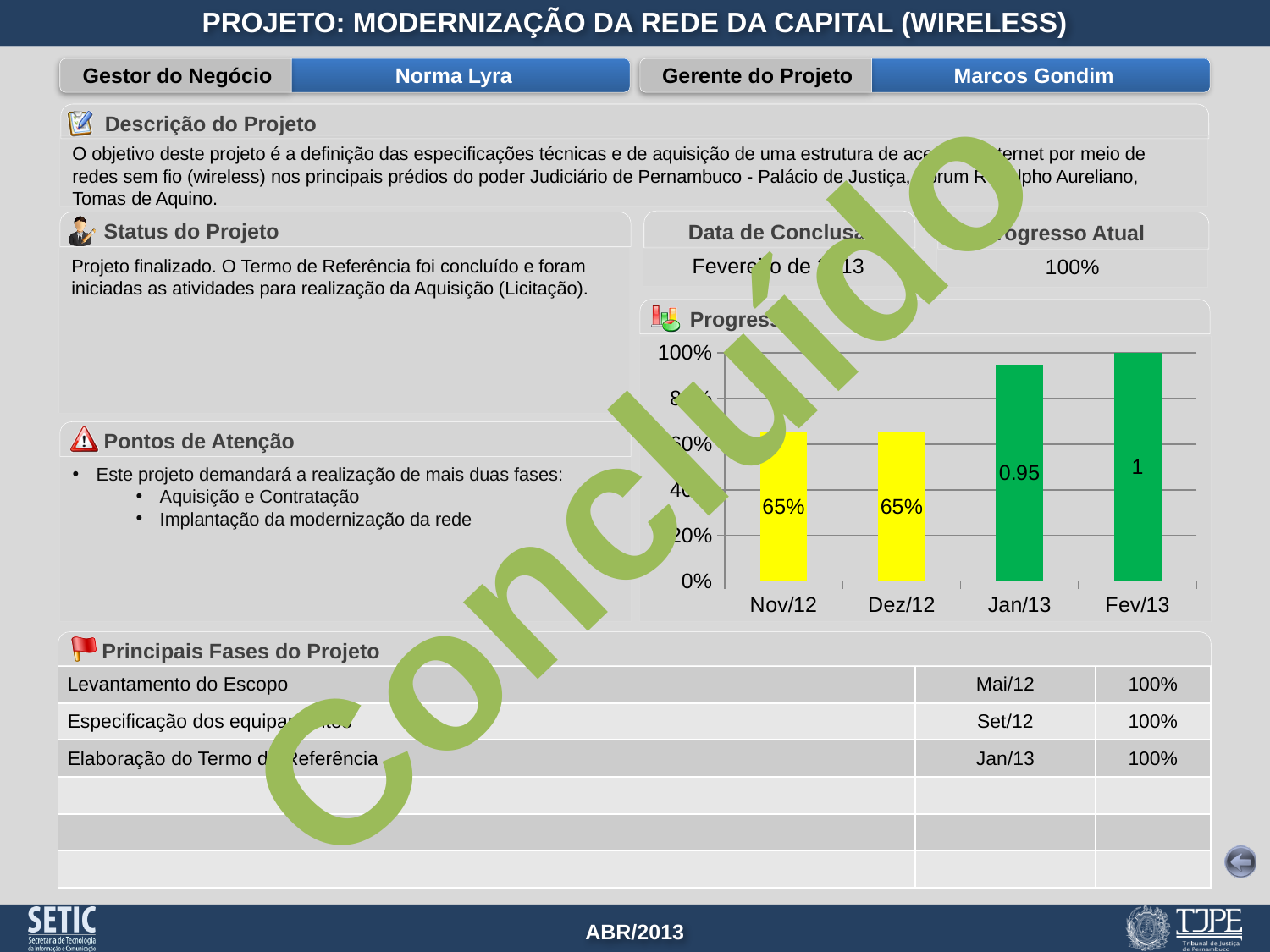
What is the value shown for Fev/13? 1 What colour are the bars for Nov/12 and Dez/12? yellow How many months are shown on the x axis of the chart? 4 Which month has the highest bar? Fev/13 Which is larger, the value for Jan/13 or the value for Nov/12? Jan/13 Is the value for Nov/12 greater or less than 80%? less What kind of chart is shown on the slide? bar chart Do the values rise or fall from Nov/12 to Fev/13? rise What is the value shown for Jan/13? 0.95 What is the value shown for Nov/12? 65% What is the value shown for Dez/12? 65% Is the value for Jan/13 greater or less than 80%? greater